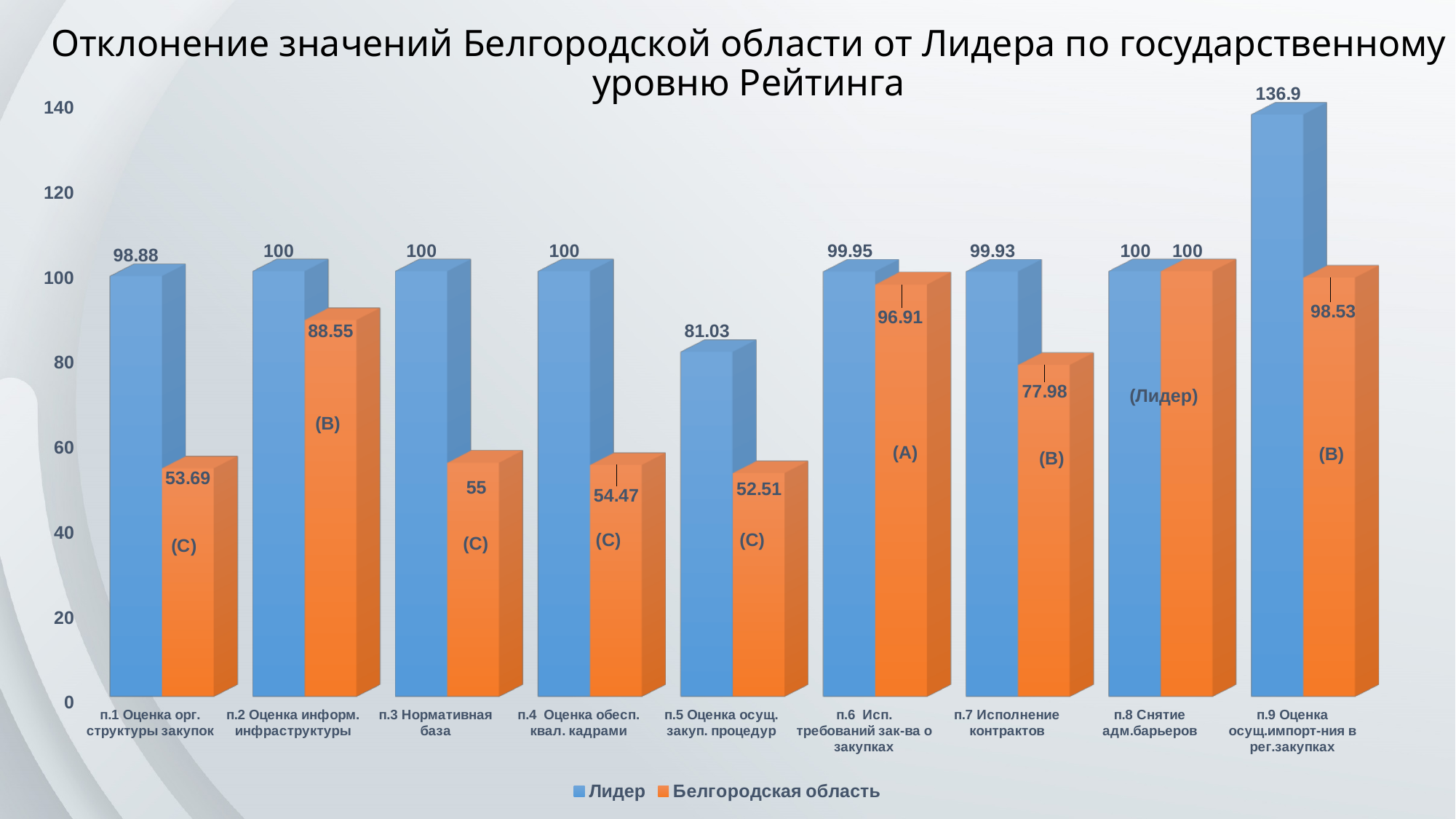
What kind of chart is shown on the slide? Bar chart Which series is shown in orange according to the legend? Белгородская область Which category has the highest value for Лидер? п.9 Оценка осущ.импорт-ния в рег.закупках How many categories are shown on the x axis? 9 What is the value for Белгородская область in category п.2 Оценка информ. инфраструктуры? 88.55 What is the difference between the Лидер and Белгородская область values in category п.9 Оценка осущ.импорт-ния в рег.закупках? 38.37 What is the value for Лидер in category п.5 Оценка осущ. закуп. процедур? 81.03 What is the value for Белгородская область in category п.7 Исполнение контрактов? 77.98 What is the value for Лидер in category п.1 Оценка орг. структуры закупок? 98.88 Which category has the lowest value for Белгородская область? п.5 Оценка осущ. закуп. процедур Which is larger in category п.6 Исп. требований зак-ва о закупках: the Лидер value or the Белгородская область value? Лидер How many series does the legend list? 2